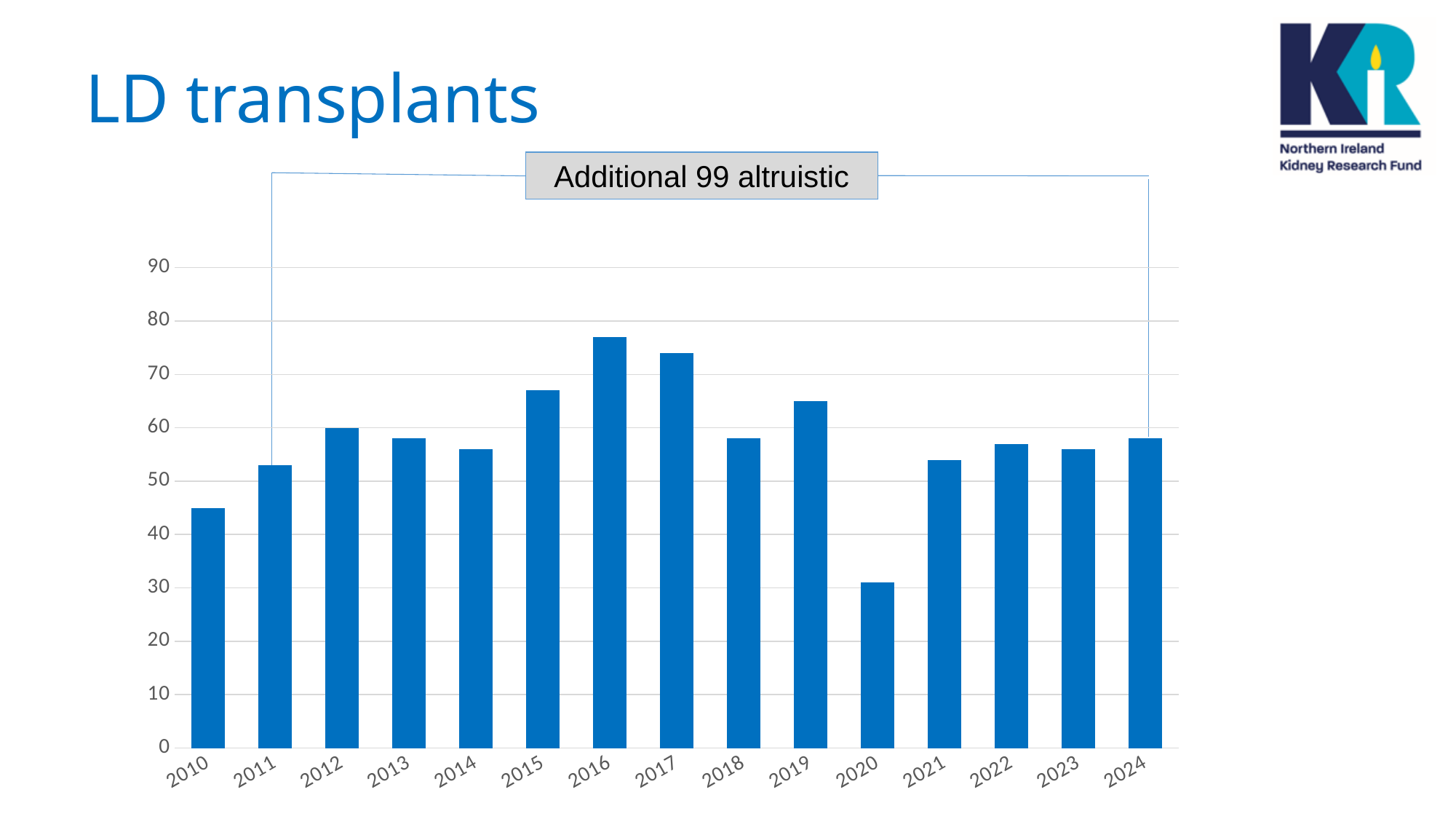
Do the values generally rise or fall from 2010 to 2016? rise Is the value for 2019 greater or less than 60? greater Is the value for 2016 greater or less than 70? greater How many years are plotted on the x axis of the chart? 15 Which year has the lowest bar in the chart? 2020 Which year has the larger value, 2015 or 2010? 2015 Which year has the highest bar in the chart? 2016 Is the value for 2020 greater or less than 40? less What does the callout box above the chart say? Additional 99 altruistic Which year has the larger value, 2018 or 2019? 2019 What kind of chart is shown on the slide? bar chart